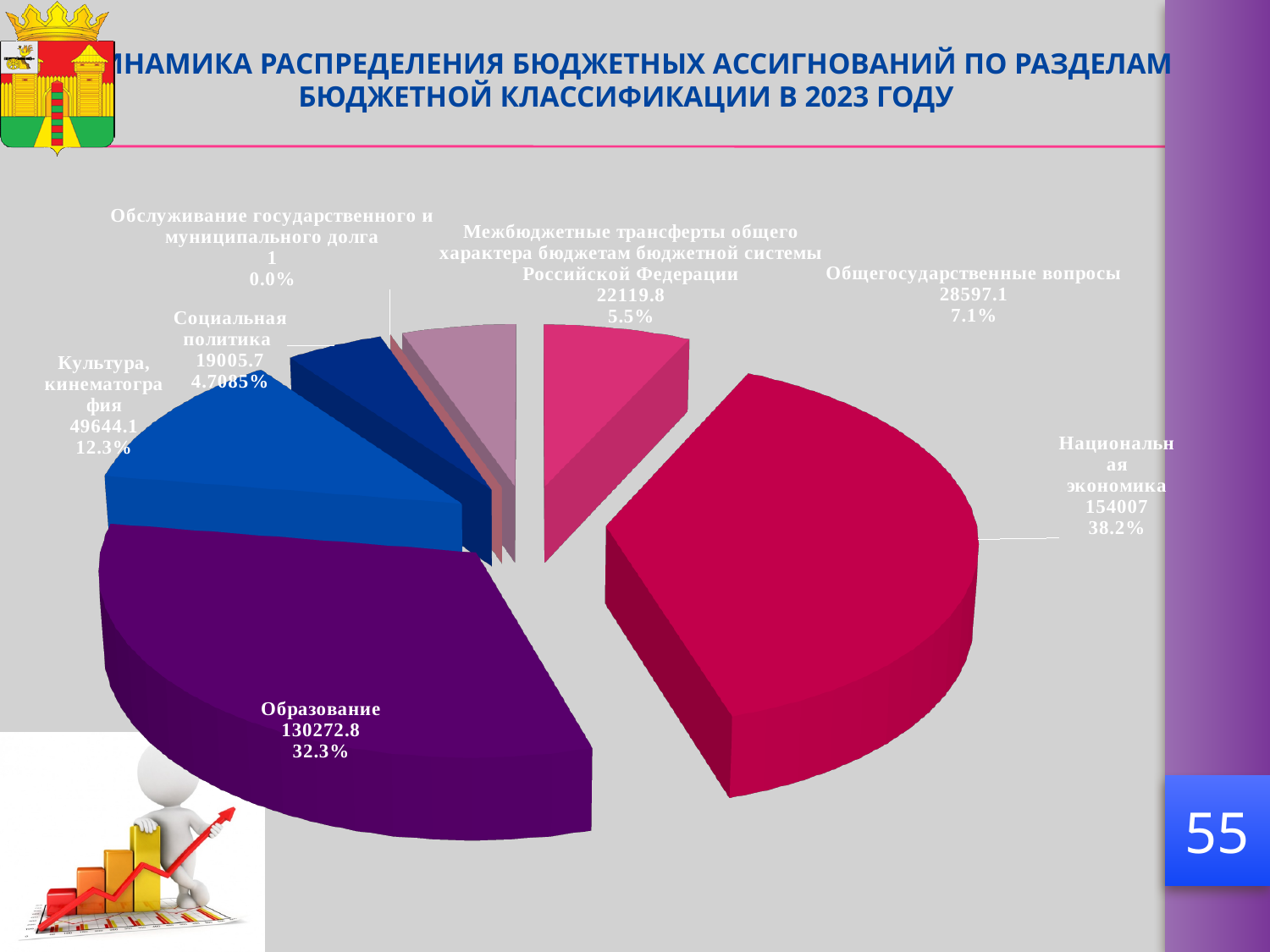
What is the difference between the values for Национальная экономика and Образование? 23734.2 What value is shown for Образование? 130272.8 What share of the pie does Межбюджетные трансферты общего характера бюджетам бюджетной системы Российской Федерации represent? 5.5% Which is larger, Общегосударственные вопросы or Межбюджетные трансферты общего характера бюджетам бюджетной системы Российской Федерации? Общегосударственные вопросы What kind of chart is shown on the slide? Pie chart What value is shown for Культура, кинематография? 49644.1 What value is shown for Национальная экономика? 154007 Which category has the largest slice of the pie? Национальная экономика Which category has the smallest slice of the pie? Обслуживание государственного и муниципального долга What is the difference between the values for Общегосударственные вопросы and Межбюджетные трансферты общего характера бюджетам бюджетной системы Российской Федерации? 6477.3 Which is larger, Образование or Культура, кинематография? Образование What share of the pie does Социальная политика represent? 4.7085%